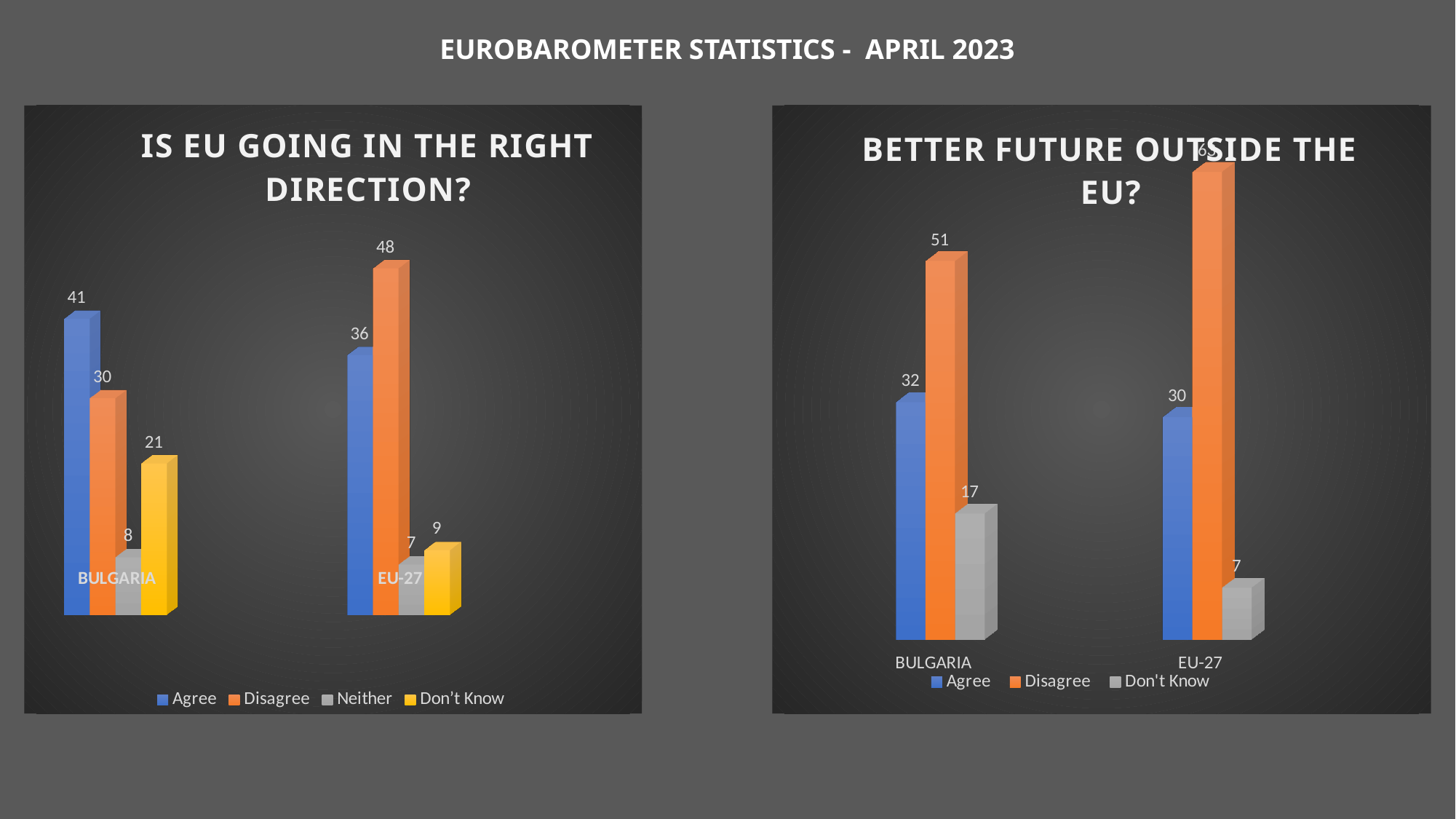
In the chart 'Is EU going in the right direction?', which response is lowest for EU-27? Neither What kind of chart is 'Better future outside the EU?'? bar chart In the chart 'Is EU going in the right direction?', what is the difference between the Agree values for Bulgaria and EU-27? 5 In the chart 'Is EU going in the right direction?', what is the Disagree value for EU-27? 48 In the chart 'Better future outside the EU?', what is the Don't Know value for EU-27? 7 In the chart 'Better future outside the EU?', is the Agree value for Bulgaria larger or smaller than the Agree value for EU-27? larger In the chart 'Is EU going in the right direction?', how many series does the legend list? 4 In the chart 'Is EU going in the right direction?', what is the Agree value for Bulgaria? 41 In the chart 'Is EU going in the right direction?', what is the Don't Know value for Bulgaria? 21 In the chart 'Better future outside the EU?', which response is highest for EU-27? Disagree In the chart 'Better future outside the EU?', what is the Disagree value for Bulgaria? 51 In the chart 'Better future outside the EU?', what is the difference between the Don't Know values for Bulgaria and EU-27? 10